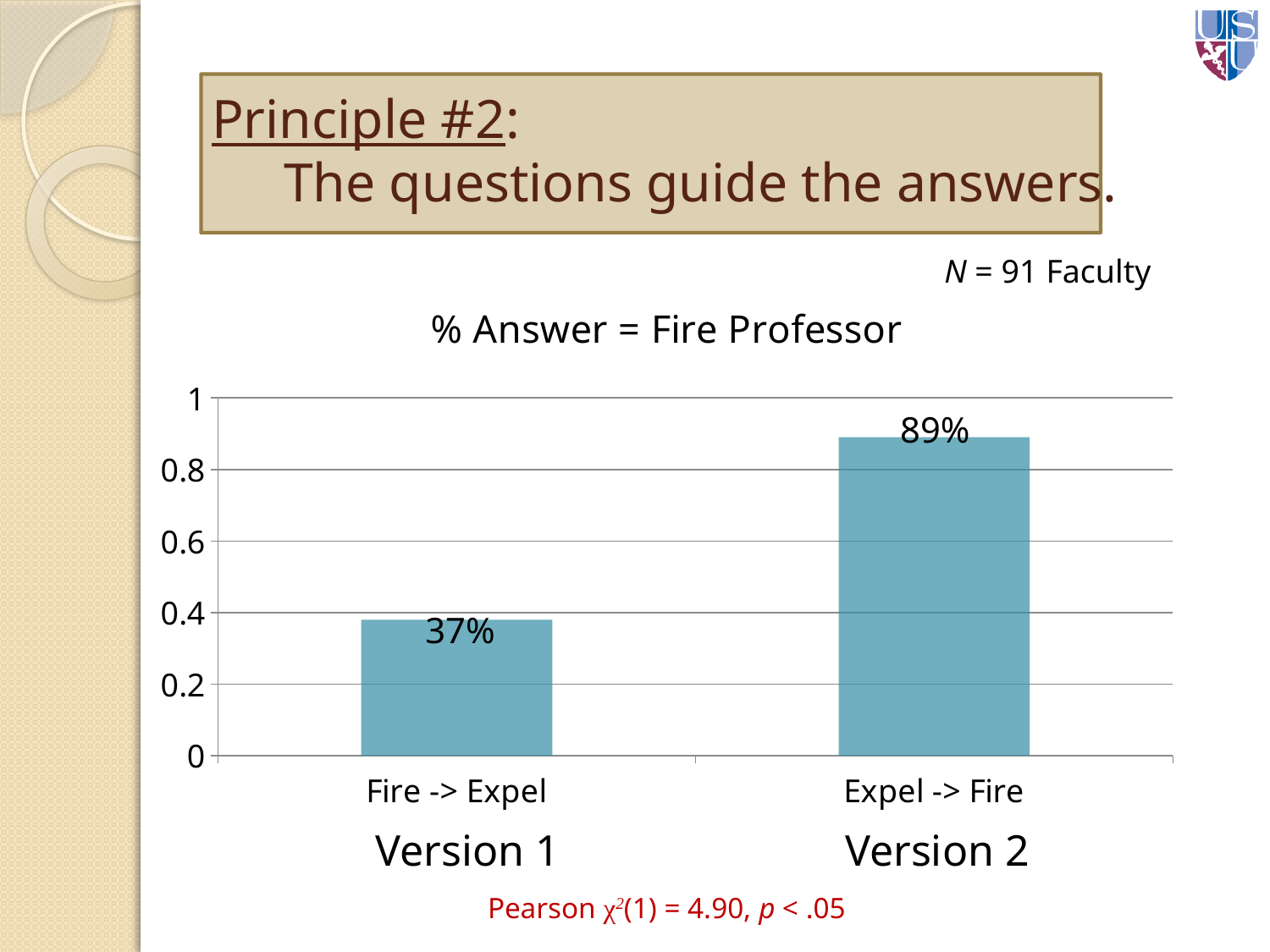
Is the value for Fire -> Expel greater or less than 0.4? less What is the highest value shown on the y axis? 1 What kind of chart is shown on the slide? bar chart Is the value for Expel -> Fire greater or less than 0.8? greater What is the difference between the values for Expel -> Fire and Fire -> Expel? 52% What is the value for Expel -> Fire? 89% Which is larger, the value for Fire -> Expel or the value for Expel -> Fire? Expel -> Fire What is the title of the chart? % Answer = Fire Professor Which category has the highest value? Expel -> Fire What is the value for Fire -> Expel? 37% How many categories are shown in the chart? 2 Which category has the lowest value? Fire -> Expel